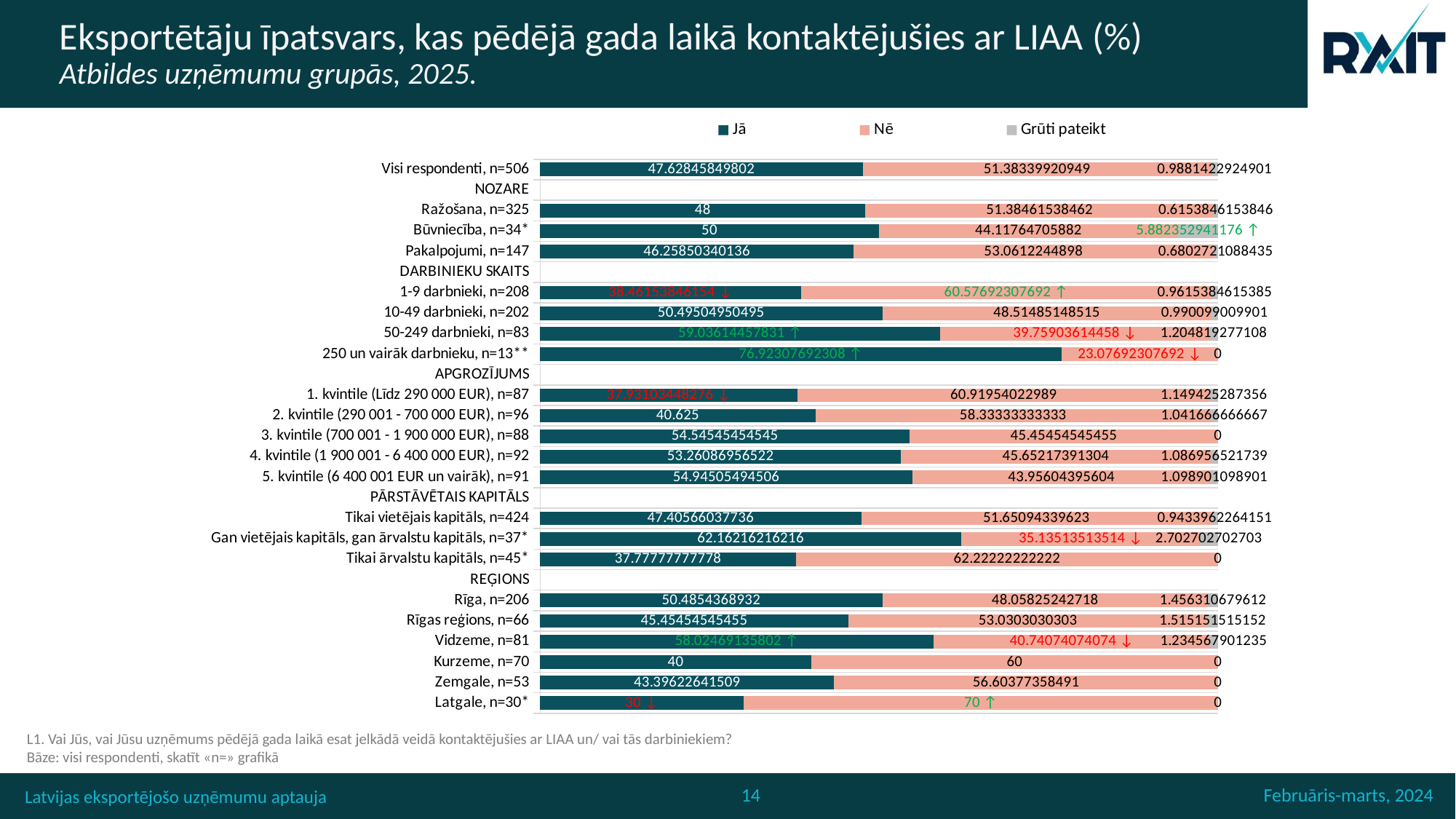
Which group has the lowest "Jā" value? Latgale, n=30* Which group has the highest "Jā" value? 250 un vairāk darbnieku, n=13** What is the total of the stacked bar for Latgale, n=30*? 100 What kind of chart is shown on the slide? Stacked bar chart What is the "Jā" value for Kurzeme, n=70? 40 Which has a larger "Jā" value: Rīga, n=206 or Kurzeme, n=70? Rīga, n=206 How many series does the legend list? 3 What is the "Nē" value for Latgale, n=30*? 70 What is the "Jā" value for Ražošana, n=325? 48 What is the "Jā" value for 2. kvintile (290 001 - 700 000 EUR), n=96? 40.625 Is the "Jā" value for Vidzeme, n=81 greater or less than 50? greater For Kurzeme, n=70, what is the difference between the "Nē" value and the "Jā" value? 20